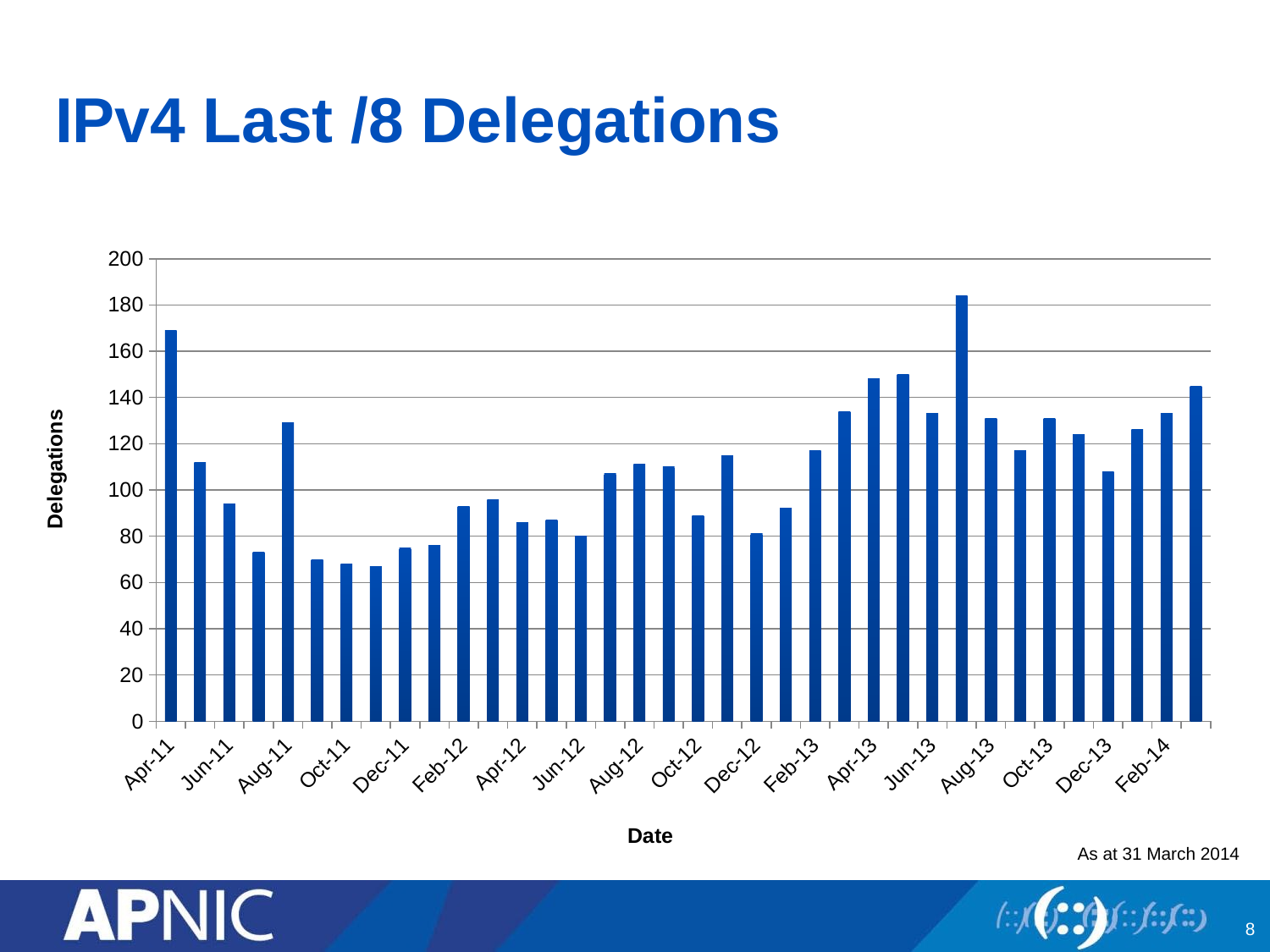
What kind of chart is shown on the slide? bar chart Is the value for Oct-11 greater or less than 80? less Which is larger, the value for Aug-11 or the value for Oct-11? Aug-11 What is the title of the x axis? Date Is the value for Dec-11 greater or less than 80? less Is the value for Jun-12 greater or less than 100? less Which is larger, the value for Apr-11 or the value for Jun-11? Apr-11 What is the title of the y axis? Delegations Do the values rise or fall from Apr-11 to Oct-11? fall